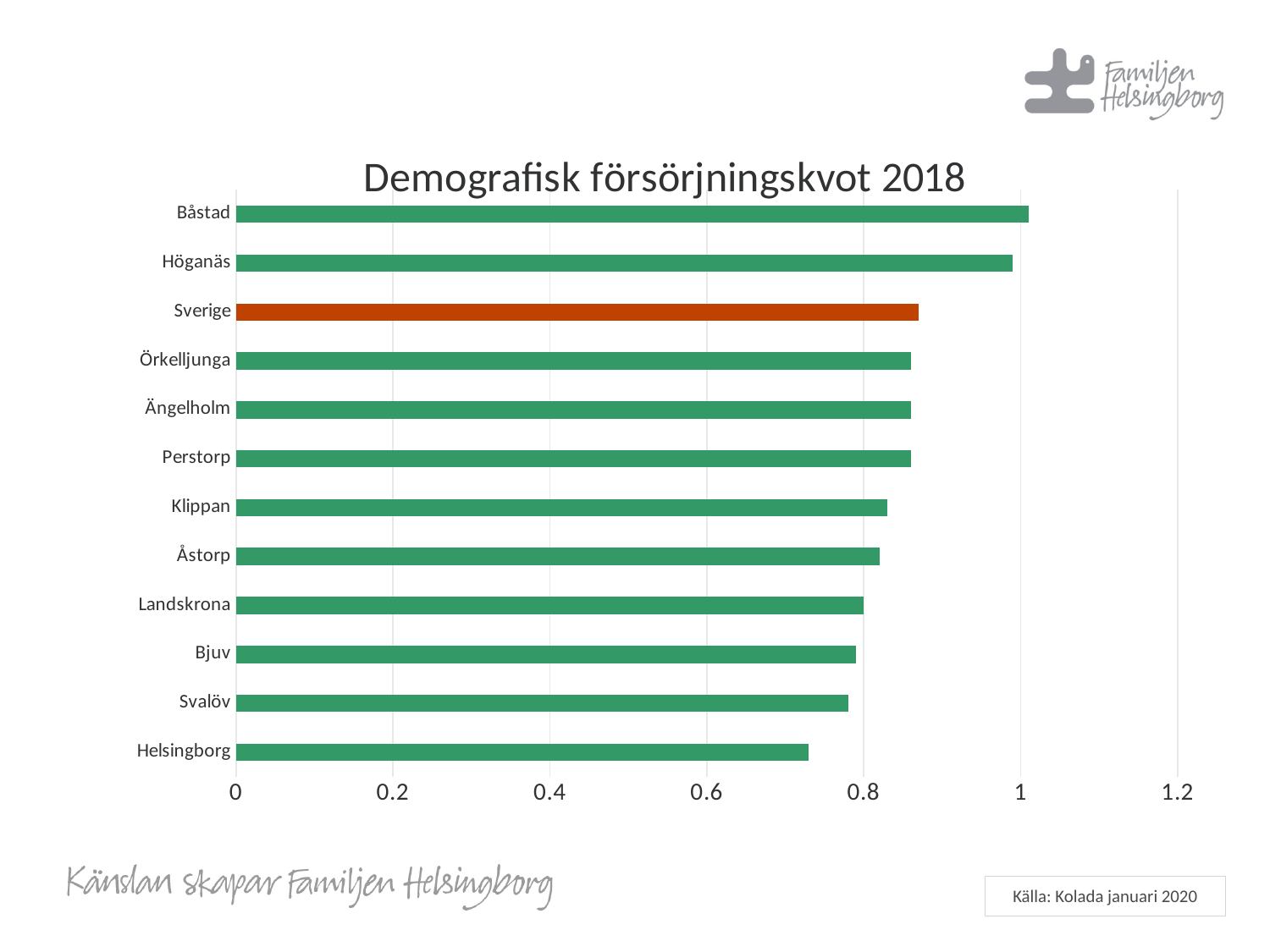
Which has a larger value, Höganäs or Klippan? Höganäs Is the value for Klippan greater or less than 0.6? greater What kind of chart is shown on the slide? bar chart Which has a larger value, Sverige or Helsingborg? Sverige Is the value for Båstad greater or less than 0.8? greater How many categories (bars) are shown in the chart? 12 Is the value for Svalöv greater or less than 0.8? less What is the title of the chart? Demografisk försörjningskvot 2018 Which bar is shown in a different colour (orange) from the other green bars? Sverige Which category has the lowest value in the chart? Helsingborg